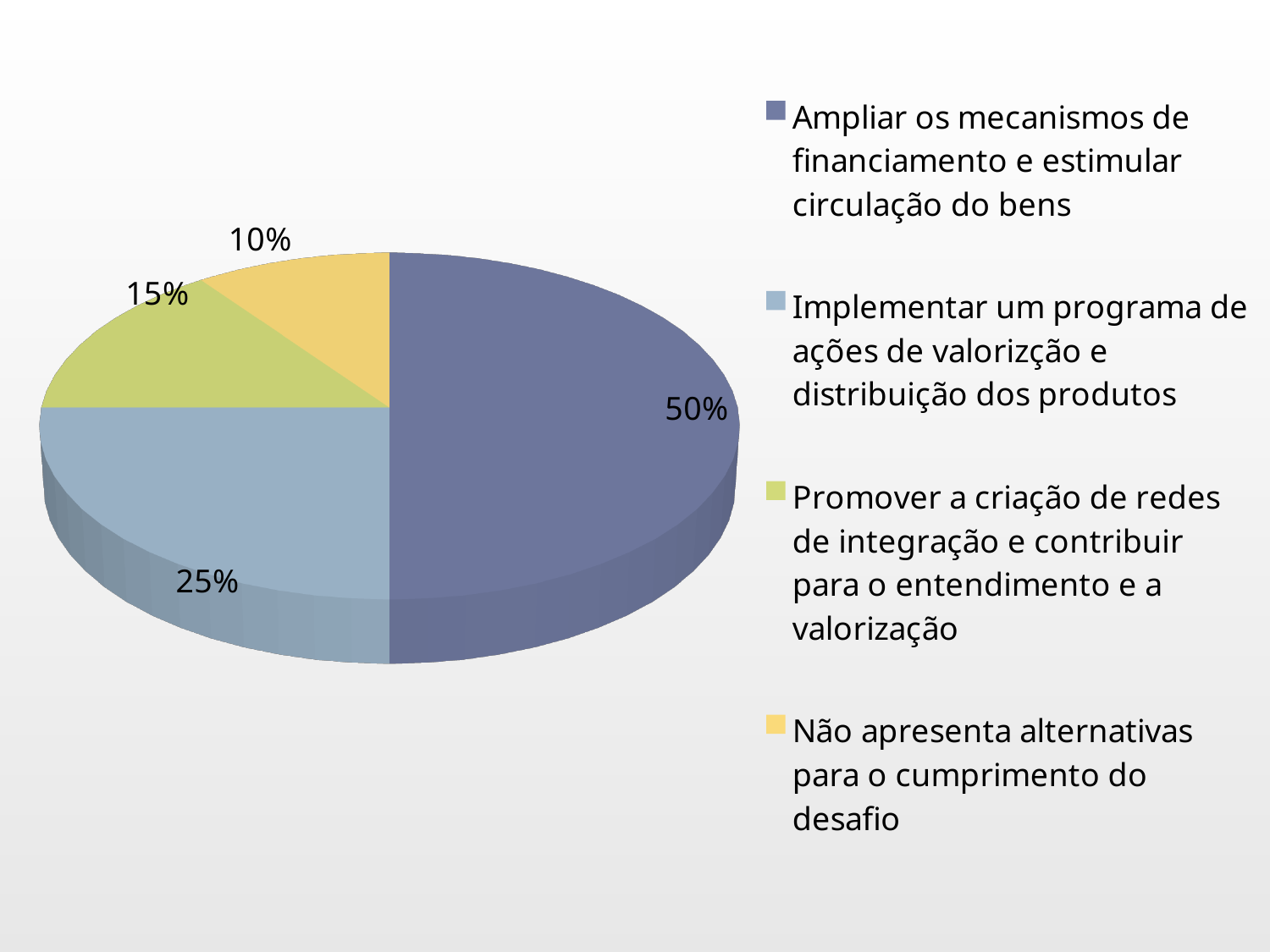
Which is larger: the slice for "Promover a criação de redes de integração e contribuir para o entendimento e a valorização" or the slice for "Não apresenta alternativas para o cumprimento do desafio"? Promover a criação de redes de integração e contribuir para o entendimento e a valorização What colour is the slice for "Não apresenta alternativas para o cumprimento do desafio"? Yellow Which category has the largest slice of the pie? Ampliar os mecanismos de financiamento e estimular circulação do bens How many slices does the pie chart have? 4 What is the difference in percentage points between the largest slice (50%) and the slice for "Implementar um programa de ações de valorizção e distribuição dos produtos"? 25 percentage points What share of the pie does "Promover a criação de redes de integração e contribuir para o entendimento e a valorização" represent? 15% What share of the pie does "Implementar um programa de ações de valorizção e distribuição dos produtos" represent? 25% How many entries does the legend list? 4 What share of the pie does "Não apresenta alternativas para o cumprimento do desafio" represent? 10% What share of the pie does "Ampliar os mecanismos de financiamento e estimular circulação do bens" represent? 50% What kind of chart is shown on the slide? Pie chart Which category has the smallest slice of the pie? Não apresenta alternativas para o cumprimento do desafio